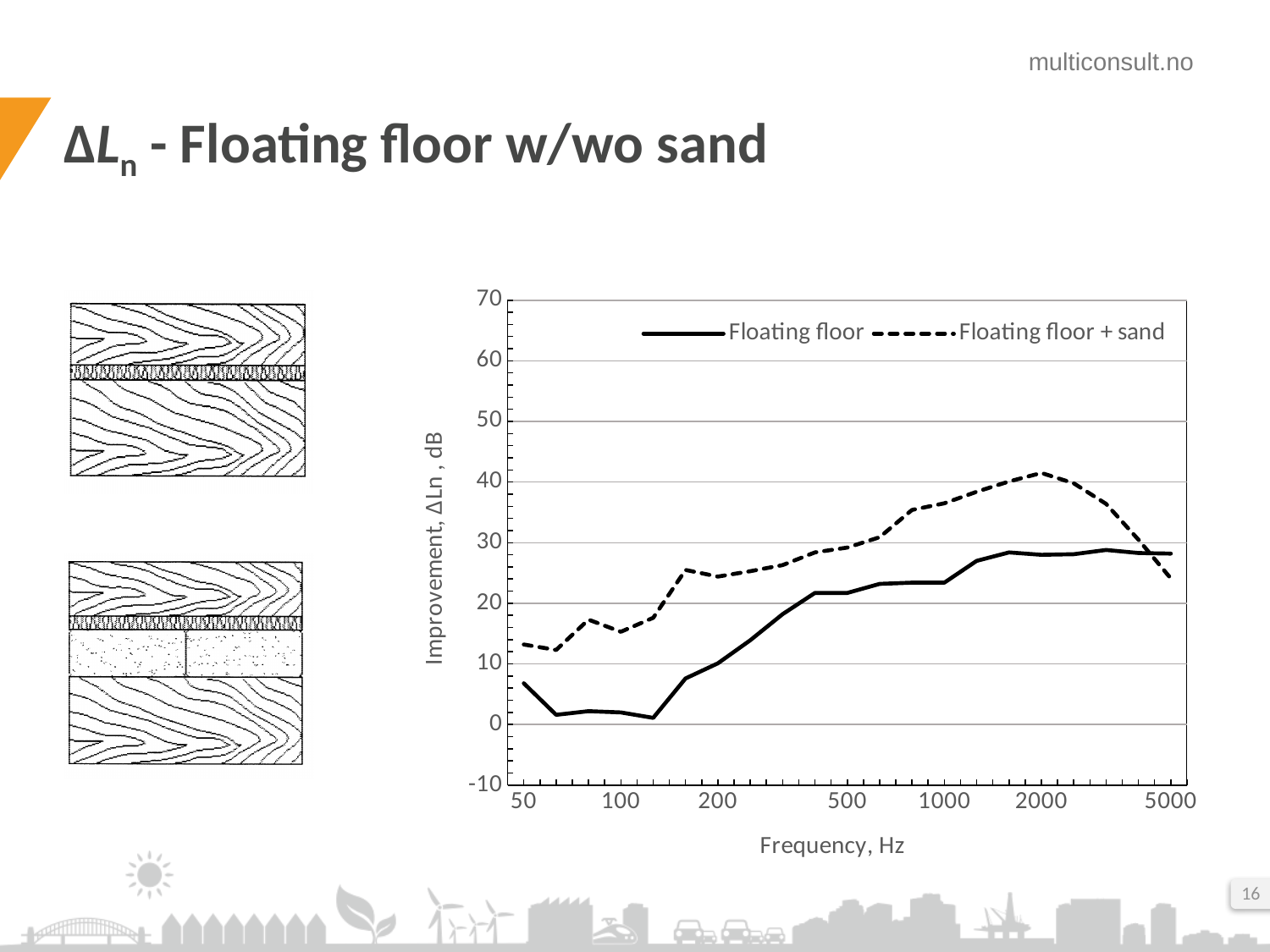
What kind of chart is shown on the slide? line chart How many series does the chart legend list? 2 Is the value for Floating floor at 5000 Hz greater or less than 20? greater At 1000 Hz, which series has the higher improvement value? Floating floor + sand Does the Floating floor series rise or fall between 200 Hz and 1000 Hz? rise Does the Floating floor + sand series rise or fall between 2000 Hz and 5000 Hz? fall At 5000 Hz, which series has the higher improvement value? Floating floor Is the value for Floating floor + sand at 50 Hz greater or less than 10? greater What is the title of the chart's vertical axis? Improvement, ΔLn , dB Is the value for Floating floor + sand at 2000 Hz greater or less than 30? greater What are the two series named in the chart legend? Floating floor; Floating floor + sand